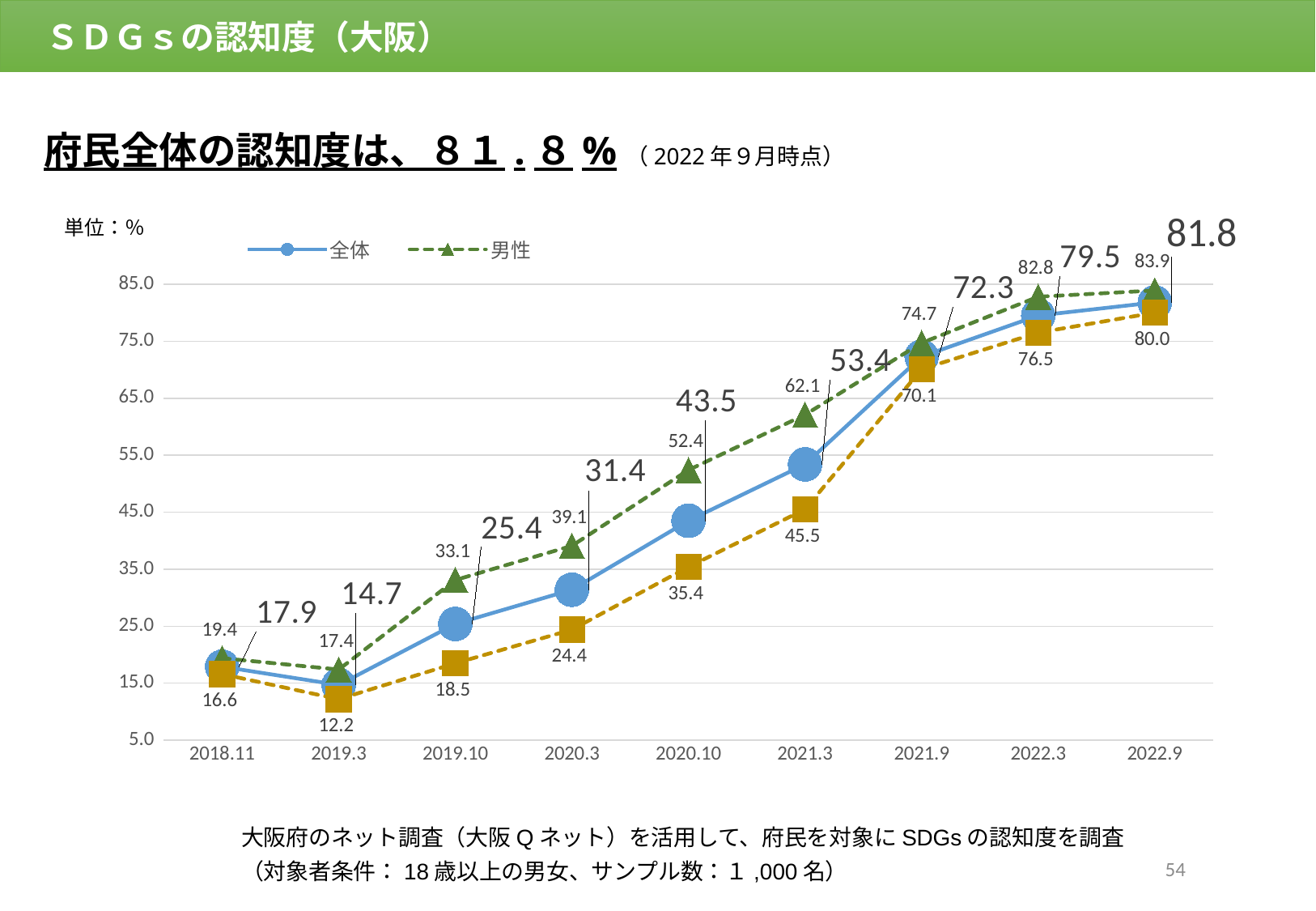
What is the value for 男性 at 2021.3? 62.1 What kind of chart is shown on the slide? line chart At which time point is the 全体 value lowest? 2019.3 What is the difference between the 男性 and 全体 values at 2020.3? 7.7 How many time points are shown on the x axis? 9 What is the value for 全体 at 2020.10? 43.5 What is the value for 全体 at 2022.9? 81.8 At which time point is the 男性 value highest? 2022.9 Which is larger at 2021.9, the 全体 value or the 男性 value? 男性 Does the 全体 value rise or fall from 2019.3 to 2022.9? rise How many series does the legend list? 2 What is the value for 男性 at 2019.10? 33.1